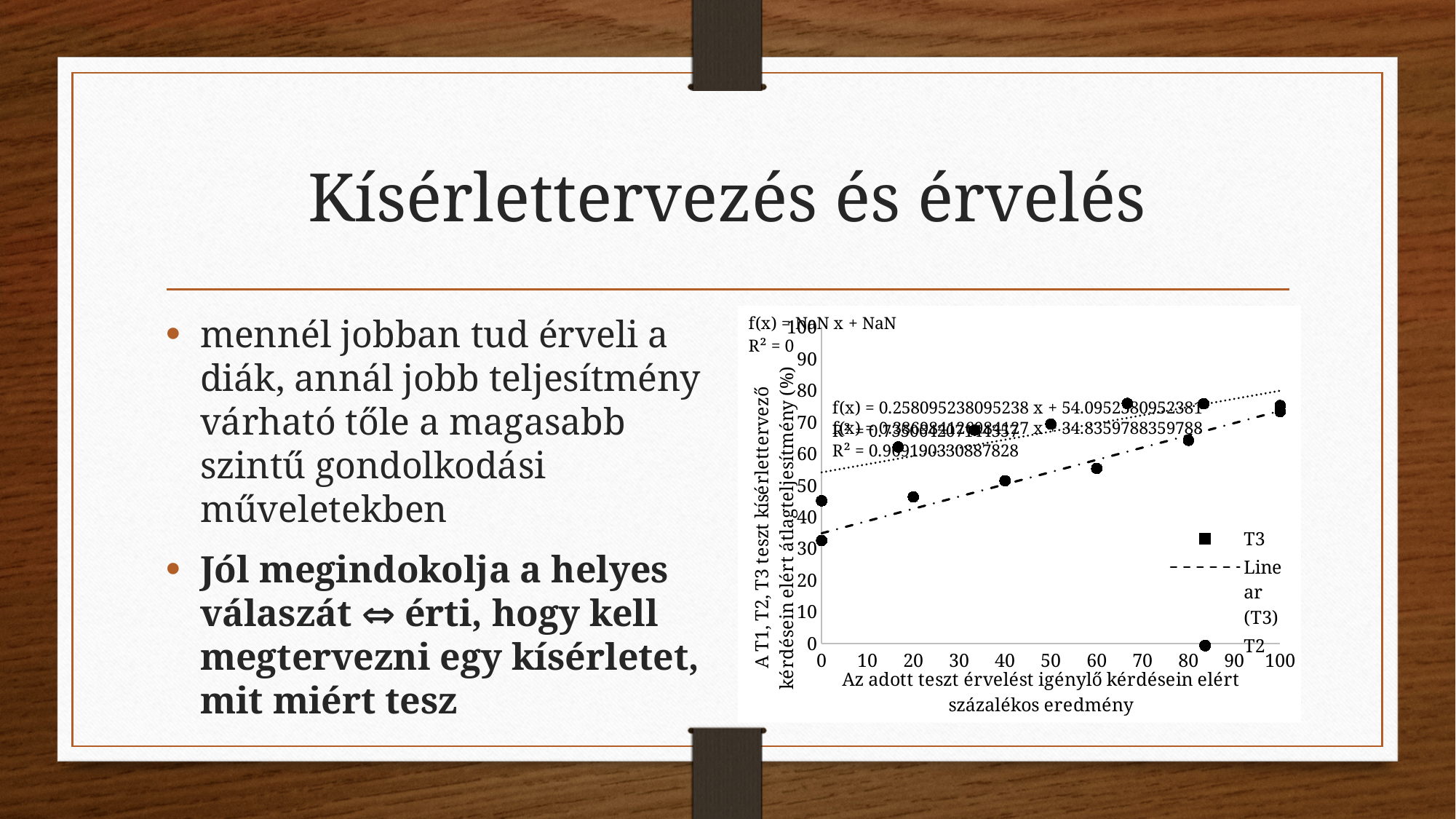
What is the R² value printed at the top left of the chart, next to f(x) = NaN x + NaN? R² = 0 What is the slope printed in the trendline equation f(x) = 0.258095238095238 x + 54.0952380952381? 0.258095238095238 Do the plotted values rise or fall as the x-axis value increases? rise What is the highest tick value shown on the y axis of the chart? 100 What is the title of the x axis of the chart? Az adott teszt érvelést igénylő kérdésein elért százalékos eredmény Is the lowest plotted point at x = 0 greater or less than 40 on the y axis? less What is the title of the y axis of the chart? A T1, T2, T3 teszt kísérlettervező kérdésein elért átlagteljesítmény (%) What kind of chart is shown on the slide? scatter chart What is the highest tick value shown on the x axis of the chart? 100 Is the plotted point at x = 20 greater or less than 50 on the y axis? less Are the plotted points at x = 100 greater or less than 70 on the y axis? greater